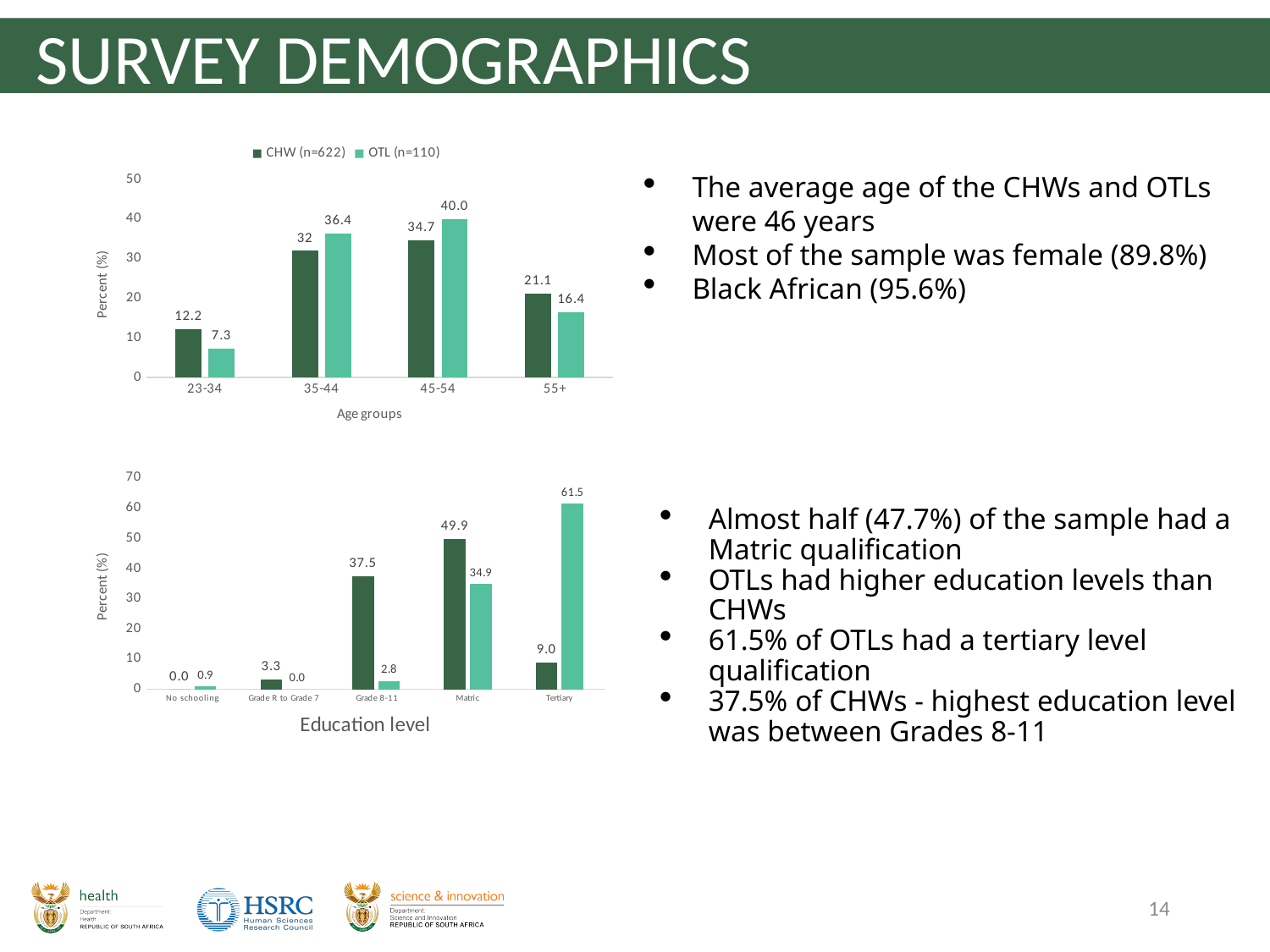
In the top chart (age groups), what is the value for CHW in the 23-34 age group? 12.2 In the top chart (age groups), what is the value for OTL in the 45-54 age group? 40.0 In the bottom chart (education level), what is the value of the taller bar for Tertiary? 61.5 In the top chart (age groups), which age group has the lowest OTL value? 23-34 In the top chart (age groups), what is the difference between the CHW and OTL values for the 55+ age group? 4.7 In the top chart (age groups), which age group has the highest CHW value? 45-54 In the top chart (age groups), how many age group categories are shown on the x axis? 4 In the bottom chart (education level), which education level has the highest dark green bar? Matric What kind of chart is the bottom chart (education level)? Bar chart In the bottom chart (education level), what is the value of the dark green bar for Grade 8-11? 37.5 In the top chart (age groups), how many series does the legend list? 2 In the bottom chart (education level), how many education level categories are shown on the x axis? 5